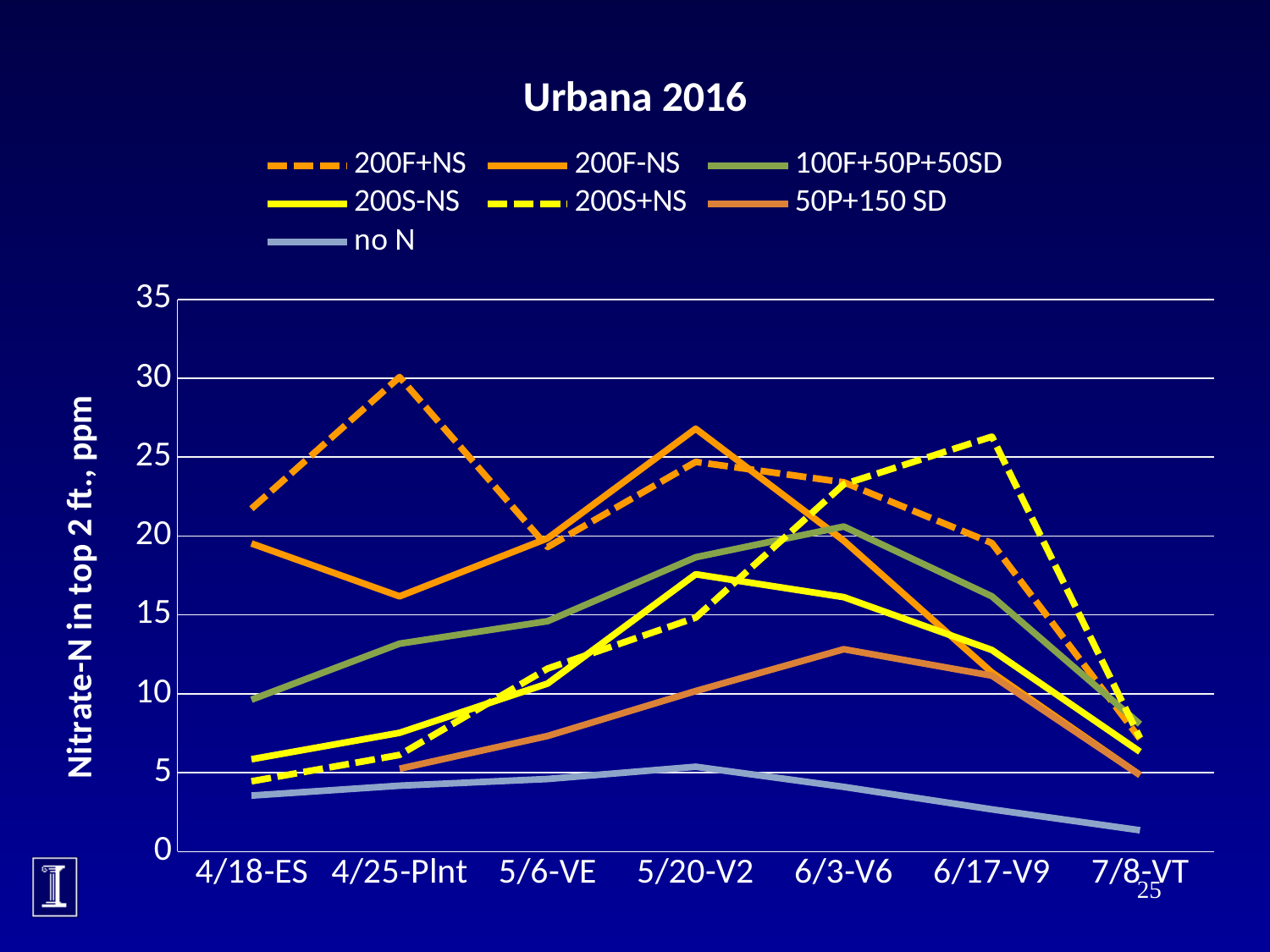
How many sampling dates are shown along the x axis? 7 What kind of chart is shown on the slide? line chart Which series has the highest value at 6/17-V9? 200S+NS Does the no N series rise or fall from 5/20-V2 to 7/8-VT? fall Is the value for 200F-NS at 5/20-V2 greater or less than 25? greater How many series does the legend list? 7 Is the value for 200F+NS at 4/25-Plnt greater or less than 25? greater At 6/17-V9, which is larger: 200S+NS or 200F-NS? 200S+NS What is the title of the chart? Urbana 2016 Which series has the highest value at 4/25-Plnt? 200F+NS Which series has the lowest value at 7/8-VT? no N Is the value for no N at 7/8-VT greater or less than 5? less